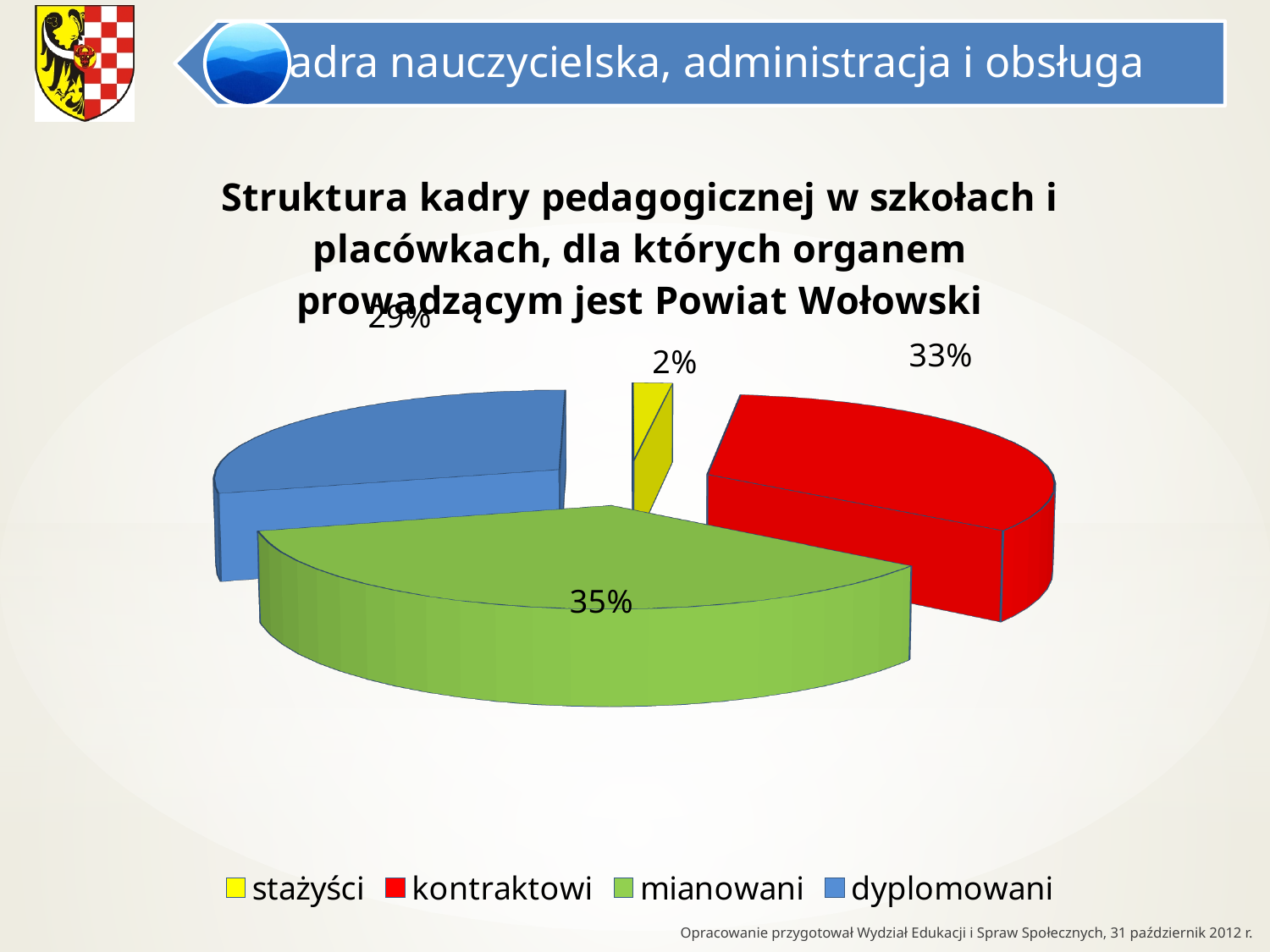
Which is larger, the share for mianowani or the share for kontraktowi? mianowani Which category has the smallest share of the pie? stażyści How many categories does the legend list? 4 What type of chart is shown on the slide? pie chart Which category is shown in yellow in the legend? stażyści What percentage of the pedagogical staff are stażyści? 2% What is the difference in percentage points between the mianowani and kontraktowi shares? 2 What is the difference in percentage points between the kontraktowi and stażyści shares? 31 What percentage of the pedagogical staff are kontraktowi? 33% What percentage of the pedagogical staff are mianowani? 35% Which category has the largest share of the pie? mianowani What colour is the slice for dyplomowani? blue